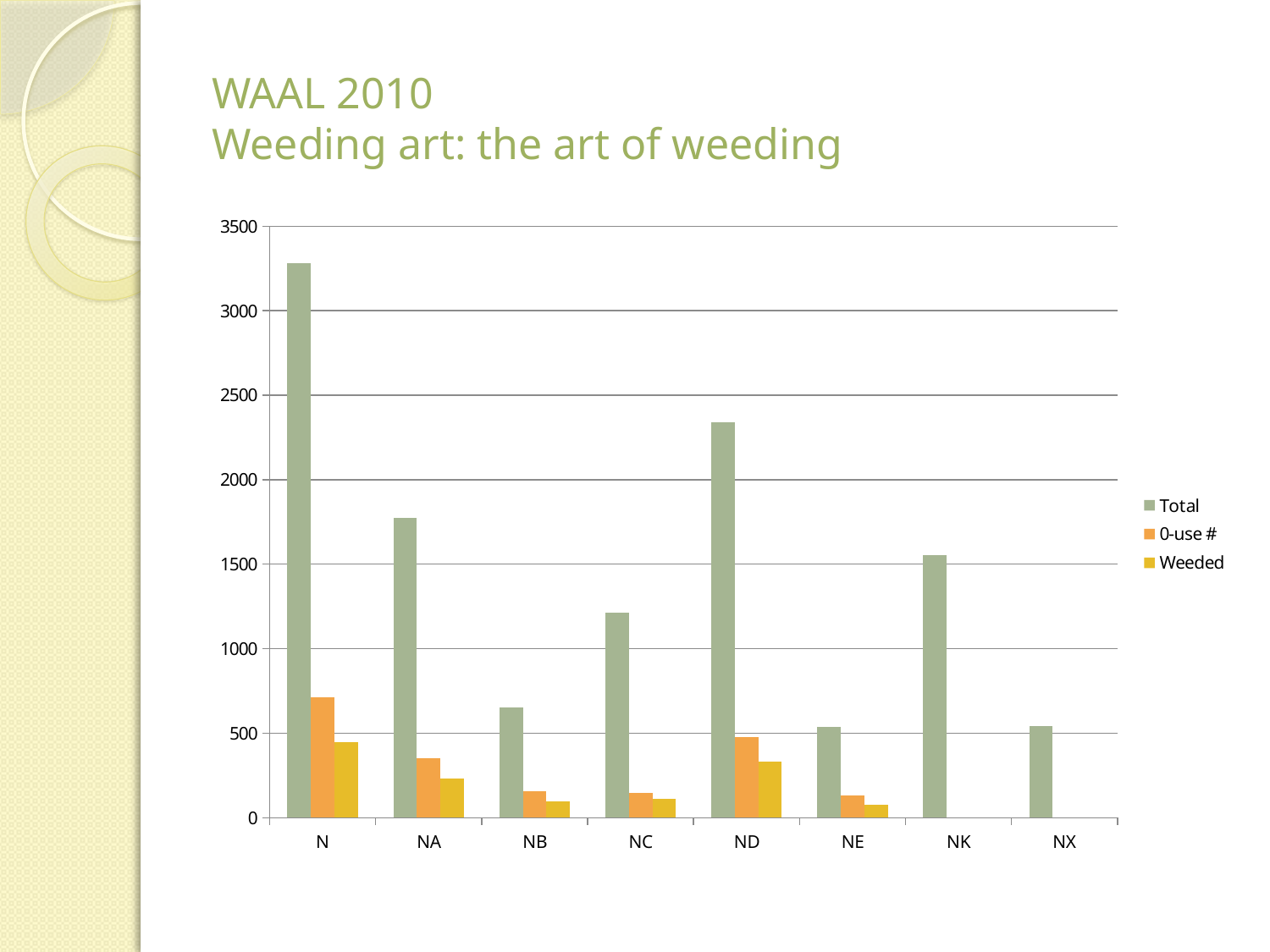
Is the Total value for N greater or less than 3000? greater How many series does the chart's legend list? 3 Is the Total value for NC greater or less than 1000? greater Which is larger, the Total value for ND or the Total value for NA? ND What kind of chart is shown on the slide? bar chart Is the Total value for ND greater or less than 2000? greater How many categories are shown on the x axis of the chart? 8 What is the title of the slide containing the chart? WAAL 2010 Weeding art: the art of weeding Which category has the highest 0-use # value? N Which category has the highest Total value? N